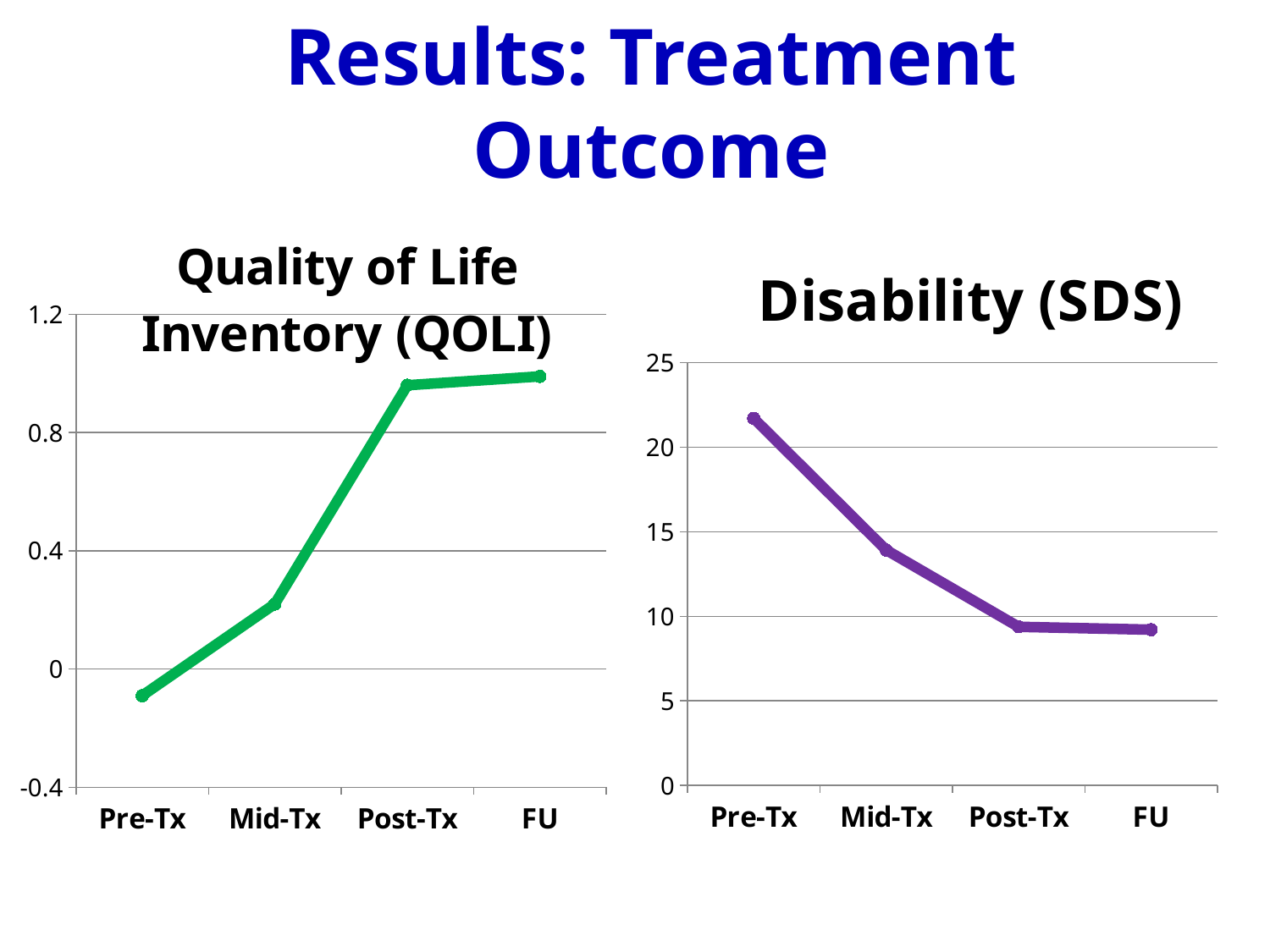
On the Disability (SDS) chart, is the value for Post-Tx greater or less than 10? less What kind of chart is the Disability (SDS) chart? line chart On the Quality of Life Inventory (QOLI) chart, do the values rise or fall from Pre-Tx to FU? rise On the Quality of Life Inventory (QOLI) chart, is the value for Post-Tx greater or less than 0.8? greater On the Quality of Life Inventory (QOLI) chart, which is larger, the value for Mid-Tx or the value for Post-Tx? Post-Tx How many time points are plotted on the Disability (SDS) chart? 4 How many time points are plotted on the Quality of Life Inventory (QOLI) chart? 4 On the Disability (SDS) chart, do the values rise or fall from Pre-Tx to FU? fall On the Disability (SDS) chart, is the value for Pre-Tx greater or less than 20? greater On the Disability (SDS) chart, which time point has the highest value? Pre-Tx On the Quality of Life Inventory (QOLI) chart, which time point has the lowest value? Pre-Tx What kind of chart is the Quality of Life Inventory (QOLI) chart? line chart